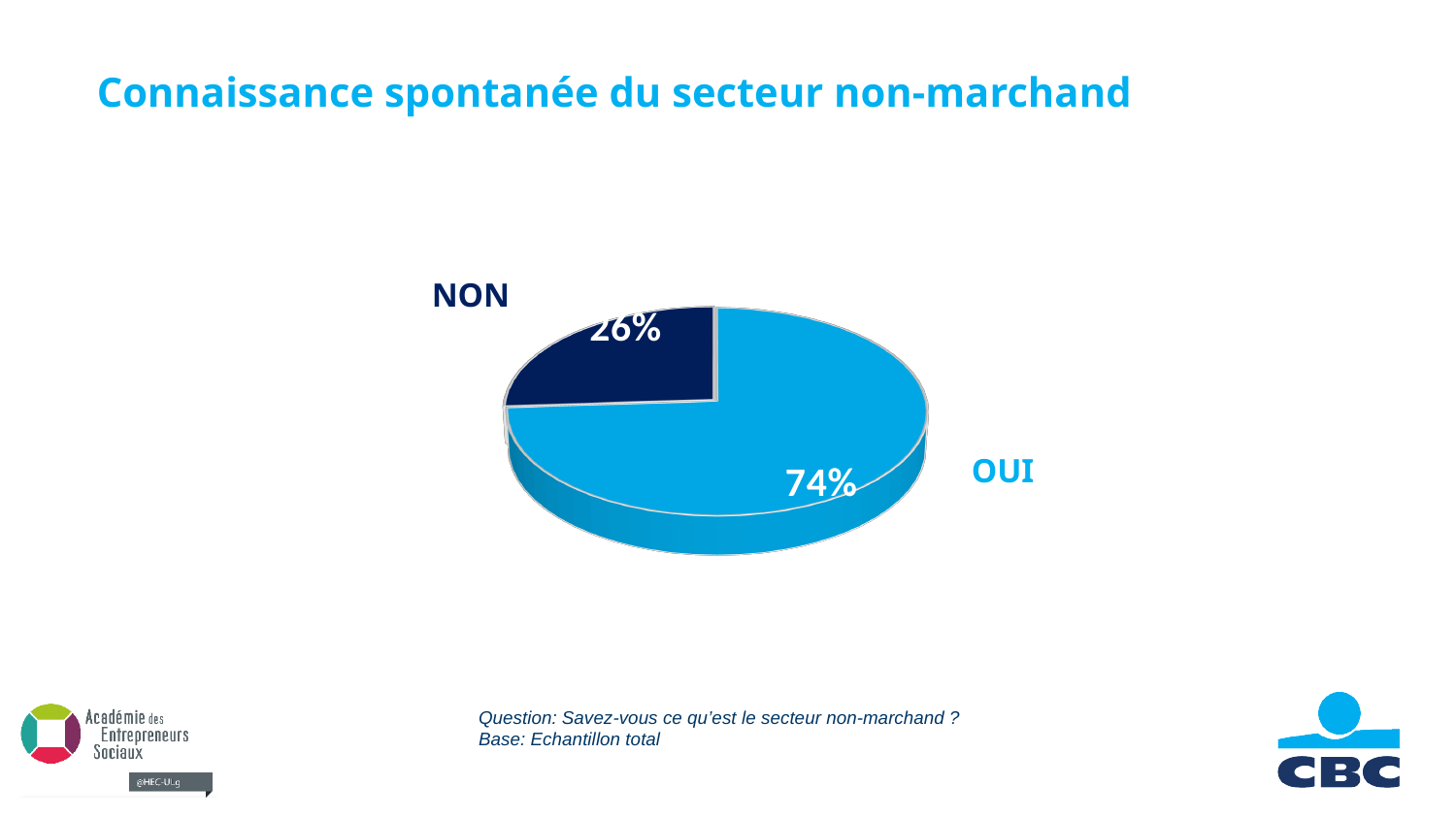
Which is larger, the OUI slice or the NON slice? OUI What share of the pie does the NON slice represent? 26% What colour is the NON slice of the pie chart? dark navy blue Is the value for OUI greater or less than 50%? greater How many slices does the pie chart have? 2 What share of the pie does the OUI slice represent? 74% Is the value for NON greater or less than 50%? less Which slice is the smallest in the pie chart? NON Which slice is the largest in the pie chart? OUI What is the title of the slide containing the pie chart? Connaissance spontanée du secteur non-marchand What is the difference in percentage points between the OUI and NON slices? 48 What kind of chart is shown on the slide? pie chart